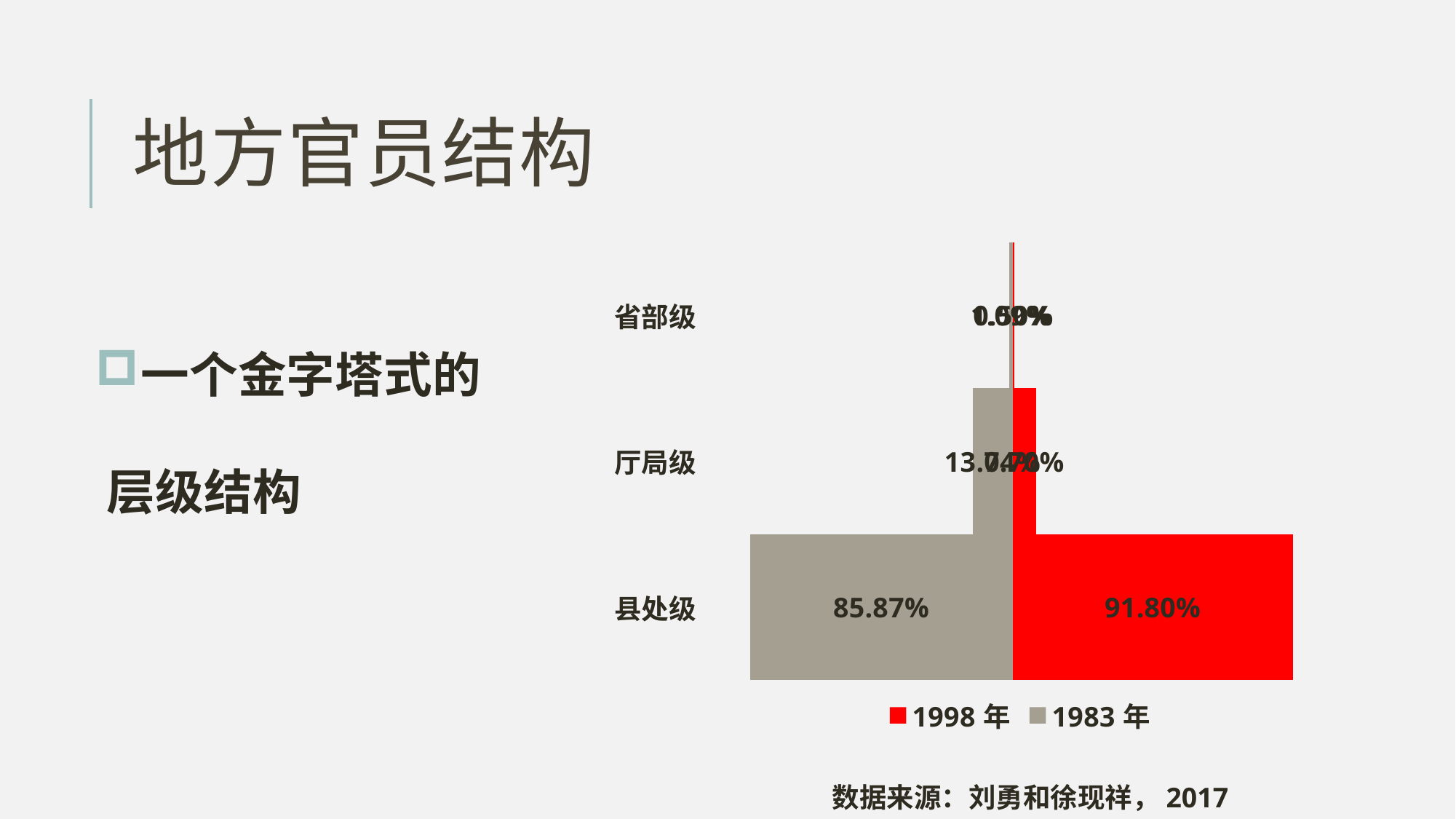
Which series is drawn in red? 1998 年 Which is larger for 县处级: the 1998 年 value or the 1983 年 value? 1998 年 How many categories are shown on the chart? 3 What kind of chart is shown on the slide? Bar chart How many series does the legend list? 2 Which category has the lowest value in the 1983 年 series? 省部级 What is the difference between the 1998 年 and 1983 年 values for 县处级? 5.93% Which category has the highest value in the 1998 年 series? 县处级 What is the value for 县处级 in the 1998 年 series? 91.80% What are the two series listed in the legend? 1998 年 and 1983 年 What is the value for 县处级 in the 1983 年 series? 85.87%